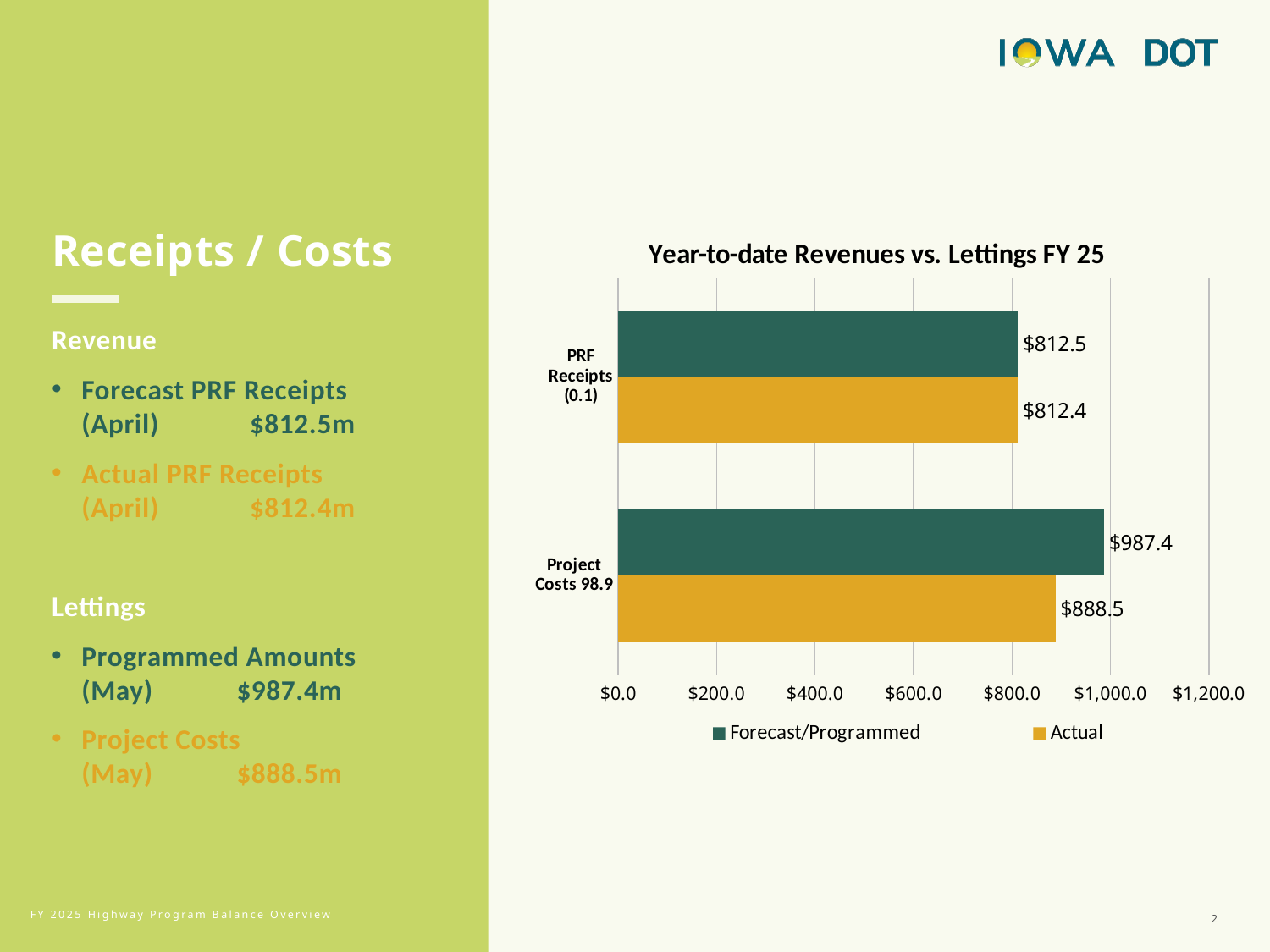
What are the two series named in the chart legend? Forecast/Programmed and Actual What is the Forecast/Programmed value for Project Costs? $987.4 Is the Actual value for Project Costs greater or less than $1,000.0? less What is the Forecast/Programmed value for PRF Receipts? $812.5 What is the difference between the Forecast/Programmed and Actual values for Project Costs? $98.9 How many series does the chart legend list? 2 What is the Actual value for PRF Receipts? $812.4 What type of chart is shown on the slide? Bar chart How many categories are plotted on the chart? 2 What is the Actual value for Project Costs? $888.5 Which is larger for Project Costs, the Forecast/Programmed value or the Actual value? Forecast/Programmed What is the title of the chart? Year-to-date Revenues vs. Lettings FY 25